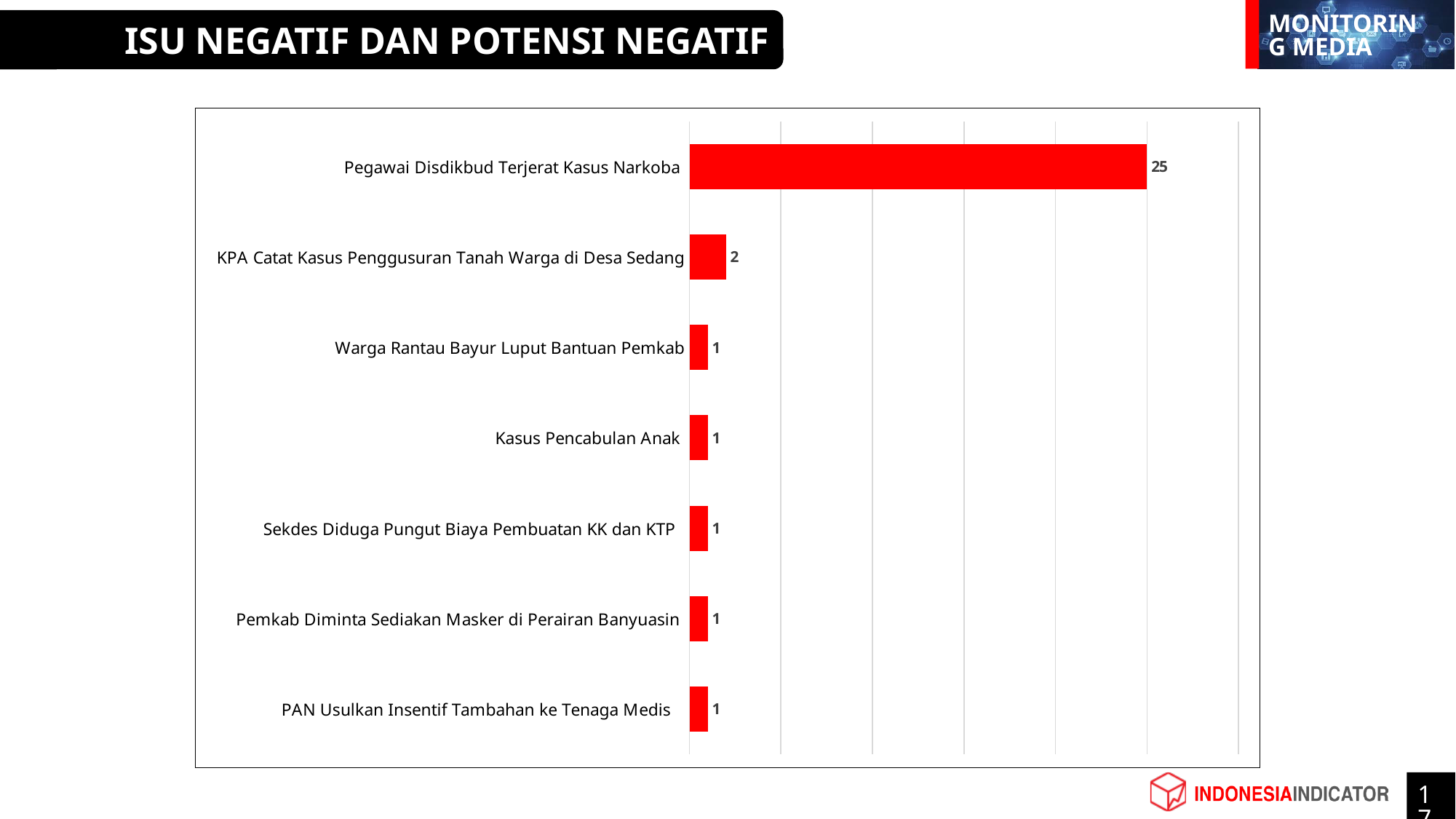
Which category has the highest value? Pegawai Disdikbud Terjerat Kasus Narkoba What is the value for "Warga Rantau Bayur Luput Bantuan Pemkab"? 1 How many categories have a value of 1? 5 Which is larger, the value for "KPA Catat Kasus Penggusuran Tanah Warga di Desa Sedang" or the value for "Sekdes Diduga Pungut Biaya Pembuatan KK dan KTP"? KPA Catat Kasus Penggusuran Tanah Warga di Desa Sedang What kind of chart is shown on the slide? Bar chart How many categories are shown in the chart? 7 What colour are the bars in the chart? Red What is the difference between the values for "Pegawai Disdikbud Terjerat Kasus Narkoba" and "KPA Catat Kasus Penggusuran Tanah Warga di Desa Sedang"? 23 What is the value for "PAN Usulkan Insentif Tambahan ke Tenaga Medis"? 1 What is the value for "Pegawai Disdikbud Terjerat Kasus Narkoba"? 25 What is the value for "KPA Catat Kasus Penggusuran Tanah Warga di Desa Sedang"? 2 What is the difference between the values for "KPA Catat Kasus Penggusuran Tanah Warga di Desa Sedang" and "Kasus Pencabulan Anak"? 1